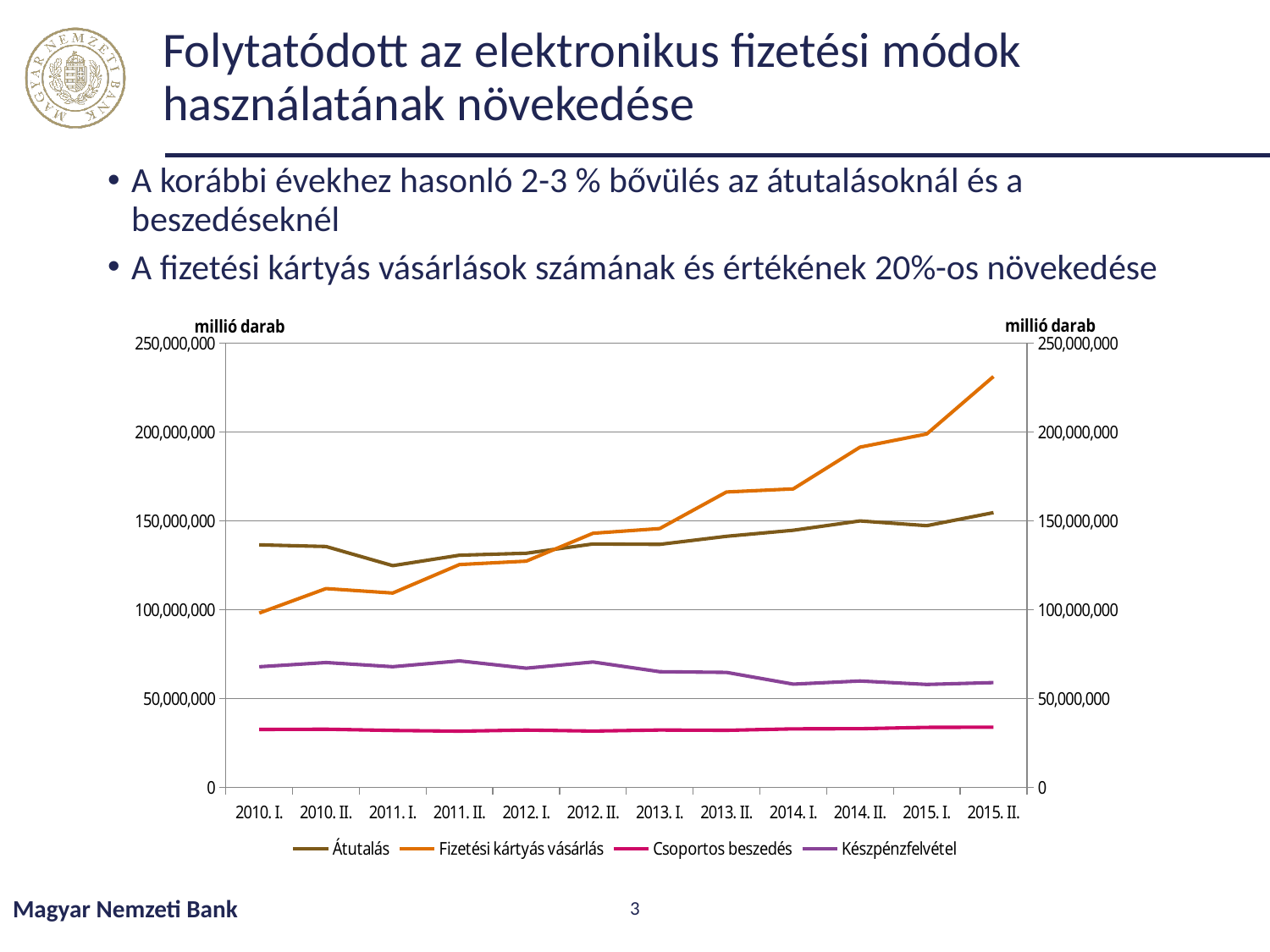
Is the value for Átutalás at 2010. I. greater or less than 100,000,000? greater What unit label is shown above the vertical axes? millió darab What kind of chart is shown on the slide? line chart Does the Fizetési kártyás vásárlás line rise or fall from 2010. I. to 2015. II.? rise Does the Készpénzfelvétel line rise or fall from 2010. I. to 2015. II.? fall Is the value for Fizetési kártyás vásárlás at 2015. II. greater or less than 200,000,000? greater How many time periods are shown on the x axis? 12 Is the value for Készpénzfelvétel at 2010. I. greater or less than 50,000,000? greater Which series has the lowest values across the whole period? Csoportos beszedés How many series does the legend list? 4 At 2015. II., which is larger: Fizetési kártyás vásárlás or Átutalás? Fizetési kártyás vásárlás